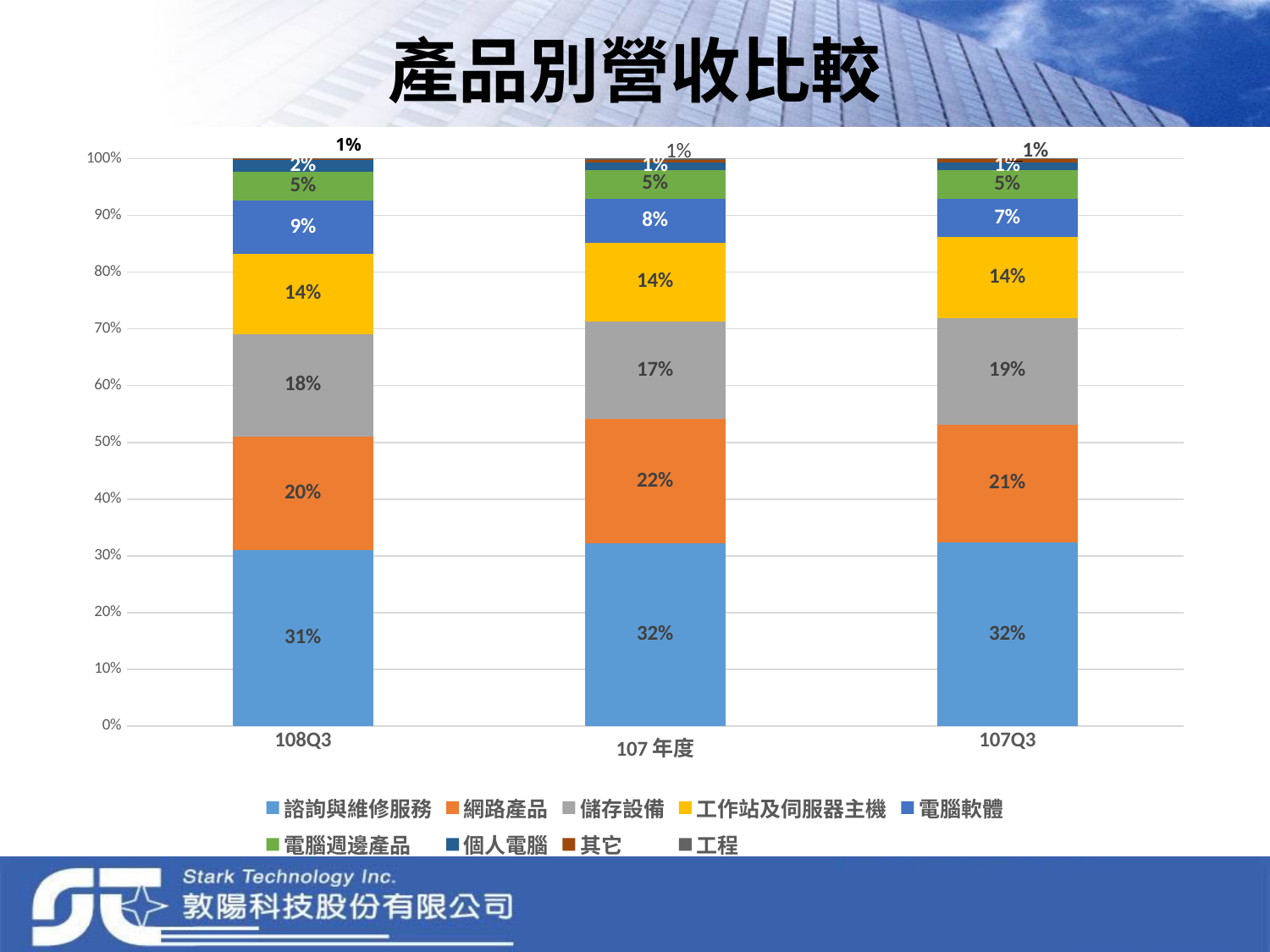
What kind of chart is shown on the slide? stacked bar chart What is the title of the chart? 產品別營收比較 How many bars (categories) are shown on the x axis? 3 Which is larger: the 儲存設備 share in 107Q3 or in 107 年度? 107Q3 What is the share of 諮詢與維修服務 in 108Q3? 31% What is the share of 儲存設備 in 107Q3? 19% Which category has the highest share of 電腦軟體? 108Q3 What is the share of 網路產品 in 107 年度? 22% Which series is shown in orange in the legend? 網路產品 What is the difference between the 網路產品 share in 107 年度 and in 108Q3? 2% What is the share of 電腦軟體 in 108Q3? 9% How many series does the legend list? 9